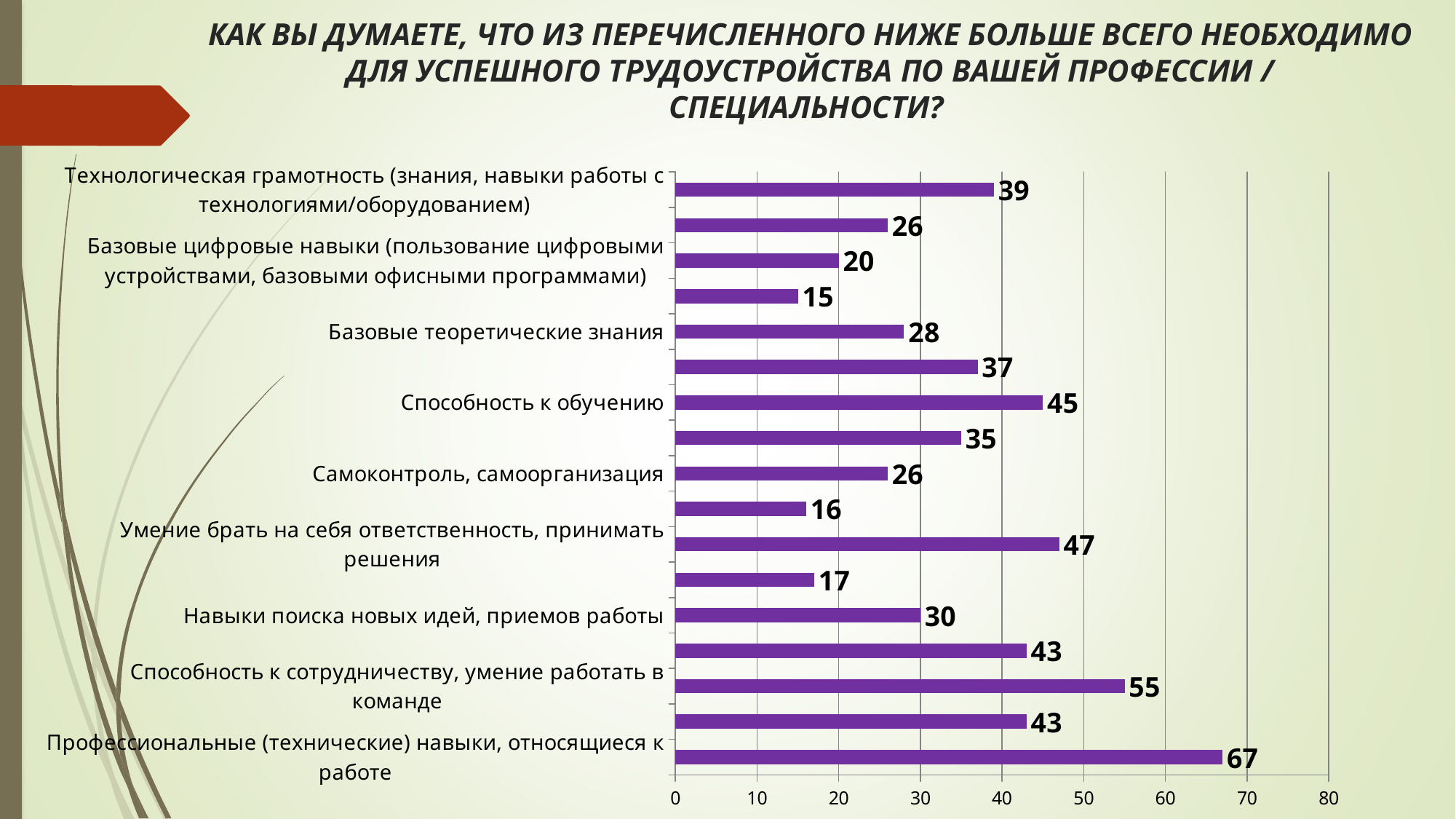
What is the difference between the values for "Профессиональные (технические) навыки, относящиеся к работе" and "Способность к сотрудничеству, умение работать в команде"? 12 What colour are the bars in the chart? purple What is the value for "Способность к обучению"? 45 What is the value for "Профессиональные (технические) навыки, относящиеся к работе"? 67 How many bars are plotted in the chart? 17 Which is larger: the value for "Умение брать на себя ответственность, принимать решения" or the value for "Навыки поиска новых идей, приемов работы"? Умение брать на себя ответственность, принимать решения What is the value for "Технологическая грамотность (знания, навыки работы с технологиями/оборудованием)"? 39 What is the value for "Базовые теоретические знания"? 28 What kind of chart is shown on the slide? bar chart Which category has the highest value in the chart? Профессиональные (технические) навыки, относящиеся к работе What is the value for "Способность к сотрудничеству, умение работать в команде"? 55 Is the value for "Самоконтроль, самоорганизация" greater or less than 30? less